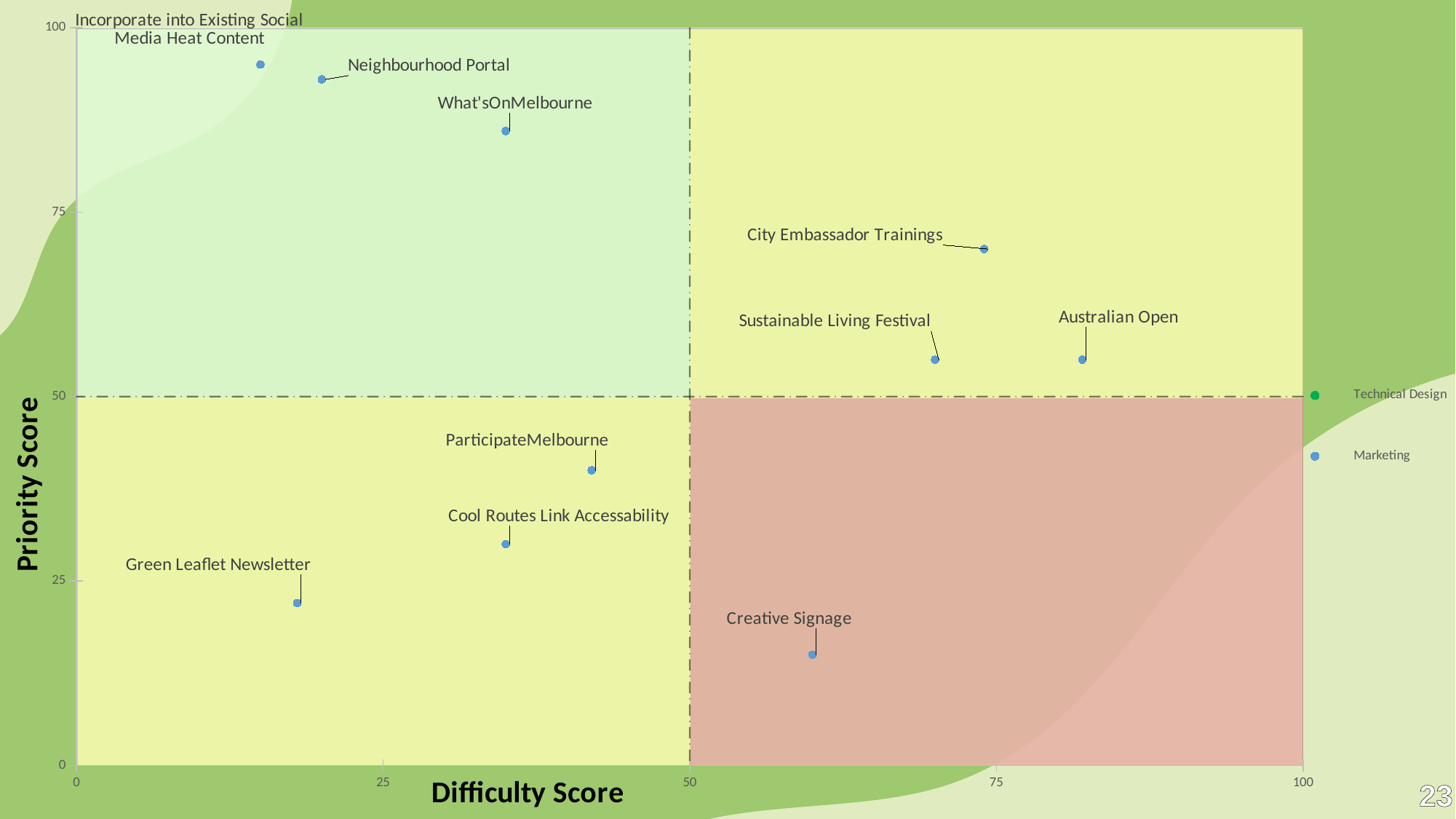
Is the Difficulty Score for Australian Open greater or less than 75? greater Which labelled point has the lowest Priority Score? Creative Signage Is the Priority Score for What'sOnMelbourne greater or less than 75? greater Which labelled point has the highest Difficulty Score? Australian Open What is the title of the horizontal axis? Difficulty Score Is the Priority Score for ParticipateMelbourne greater or less than 50? less What kind of chart is shown on the slide? scatter chart What are the two entries listed in the legend? Technical Design and Marketing How many series does the legend list? 2 How many data points are plotted on the chart? 10 Which has the higher Priority Score, Green Leaflet Newsletter or Creative Signage? Green Leaflet Newsletter